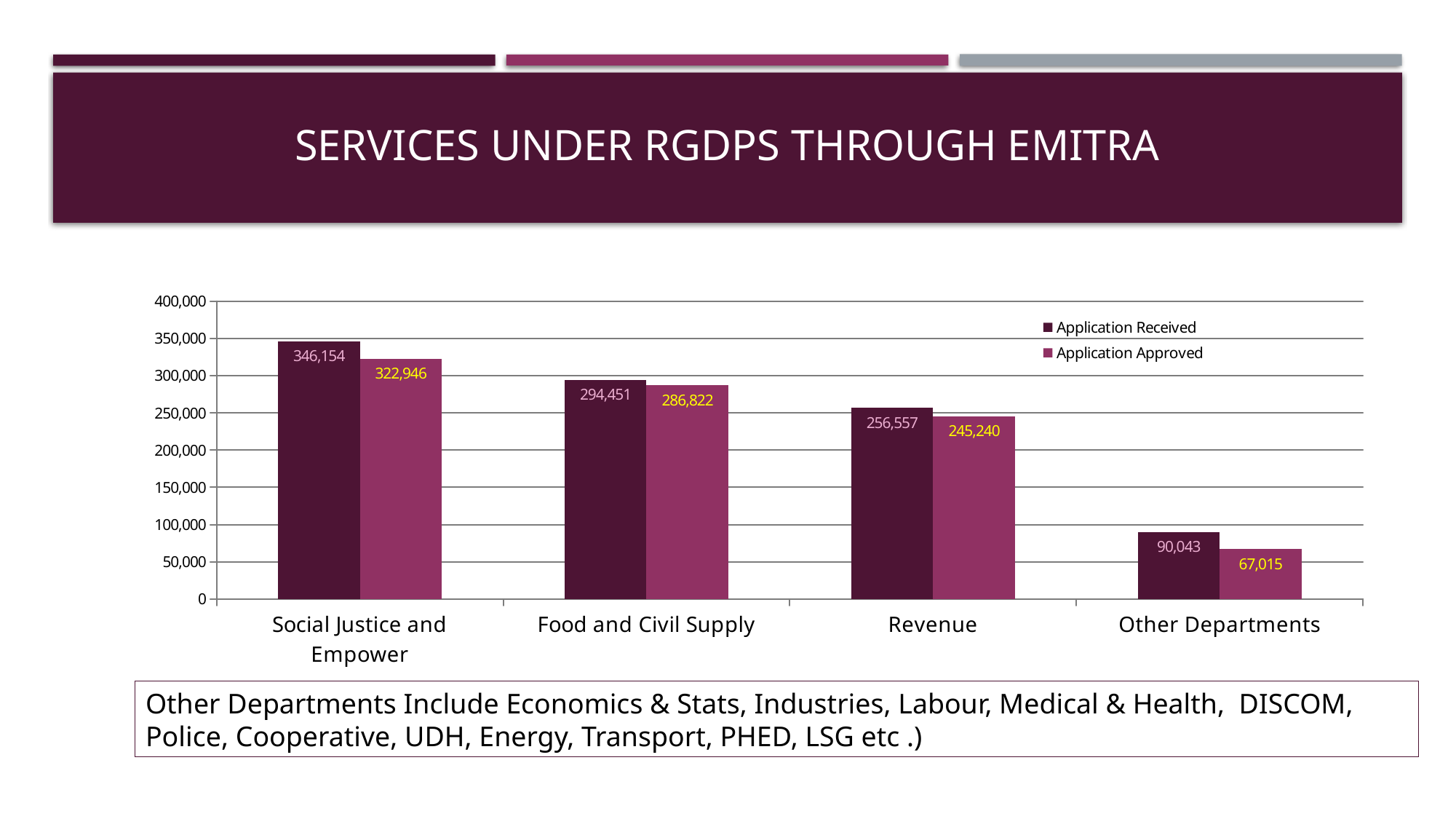
What is the difference between applications received and applications approved for Revenue? 11,317 Which is larger: applications approved for Social Justice and Empower or applications received for Food and Civil Supply? Applications approved for Social Justice and Empower Which department has the lowest number of applications approved? Other Departments How many applications were received for Social Justice and Empower? 346,154 Which department has the highest number of applications received? Social Justice and Empower What is the Application Received value for Revenue? 256,557 How many applications were approved for Food and Civil Supply? 286,822 How many series does the legend list? 2 Do the Application Received values rise or fall from left to right across the departments? Fall What is the Application Approved value for Other Departments? 67,015 How many departments (categories) are shown on the x axis? 4 What kind of chart is shown on the slide? Bar chart